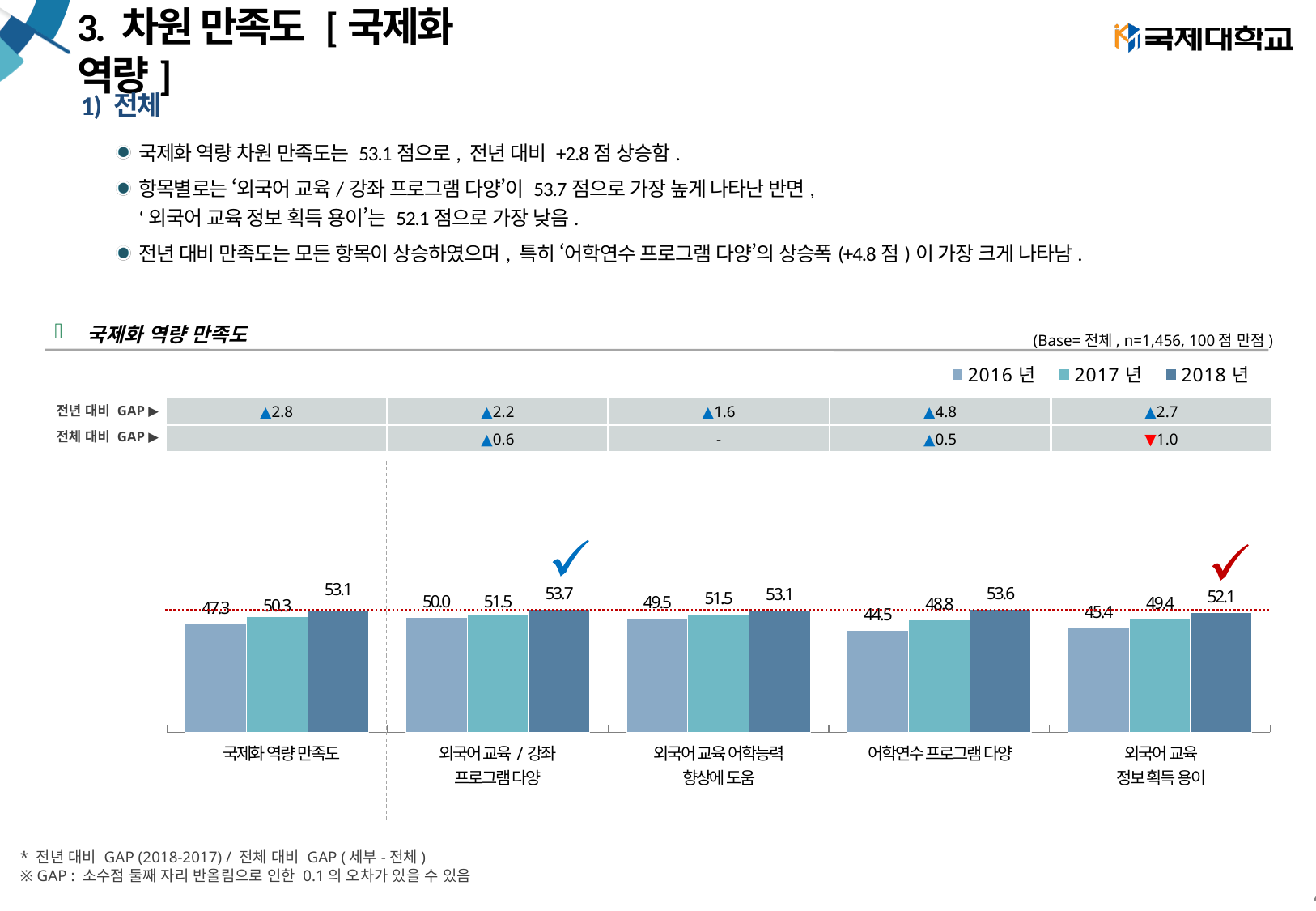
How many categories are shown along the x axis of the chart? 5 What is the 2017년 value for 외국어 교육 정보 획득 용이? 49.4 What type of chart is shown on the slide? bar chart What is the 2018년 value for 국제화 역량 만족도? 53.1 Which category has the lowest 2016년 value? 어학연수 프로그램 다양 Which series in the legend is shown in the darkest blue? 2018 년 What is the 2016년 value for 어학연수 프로그램 다양? 44.5 What is the difference between the 2018년 and 2017년 values for 어학연수 프로그램 다양? 4.8 Do the values for 외국어 교육 정보 획득 용이 rise or fall from 2016년 to 2018년? rise Which is larger, the 2018년 value for 외국어 교육 어학능력 향상에 도움 or the 2018년 value for 외국어 교육 정보 획득 용이? 외국어 교육 어학능력 향상에 도움 How many series does the chart legend list? 3 Which category has the highest 2018년 value? 외국어 교육 / 강좌 프로그램 다양